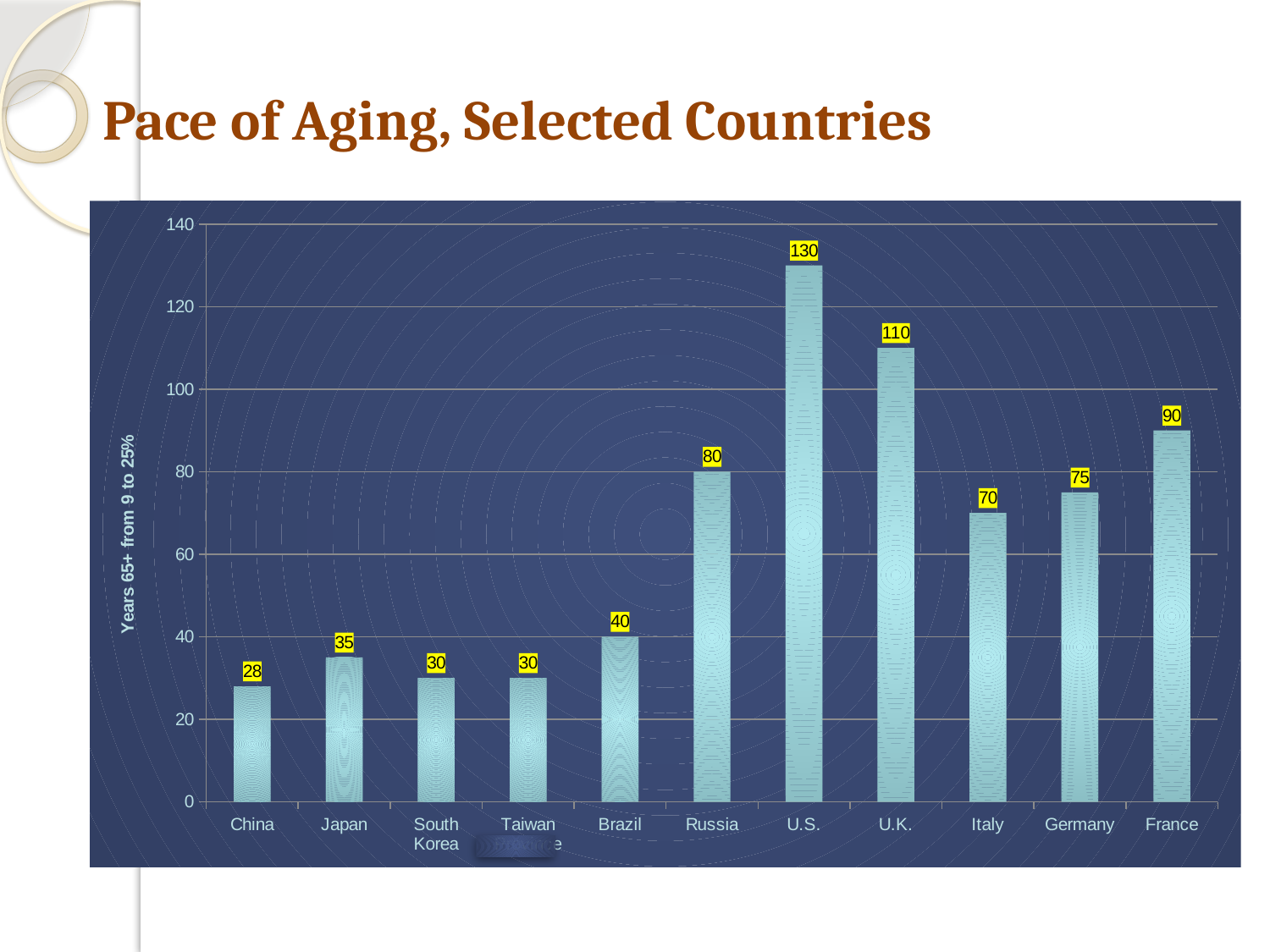
What is the value for Germany? 75 What is the difference between the values for France and Brazil? 50 What is the value for the U.S.? 130 Which is larger, the value for Russia or the value for Italy? Russia What kind of chart is shown on the slide? bar chart What is the difference between the values for the U.S. and the U.K.? 20 What is the value for China? 28 Which country has the lowest value? China How many countries are shown on the chart? 11 What is the title of the slide? Pace of Aging, Selected Countries Which country has the highest value? U.S. What is the label on the vertical axis? Years 65+ from 9 to 25%